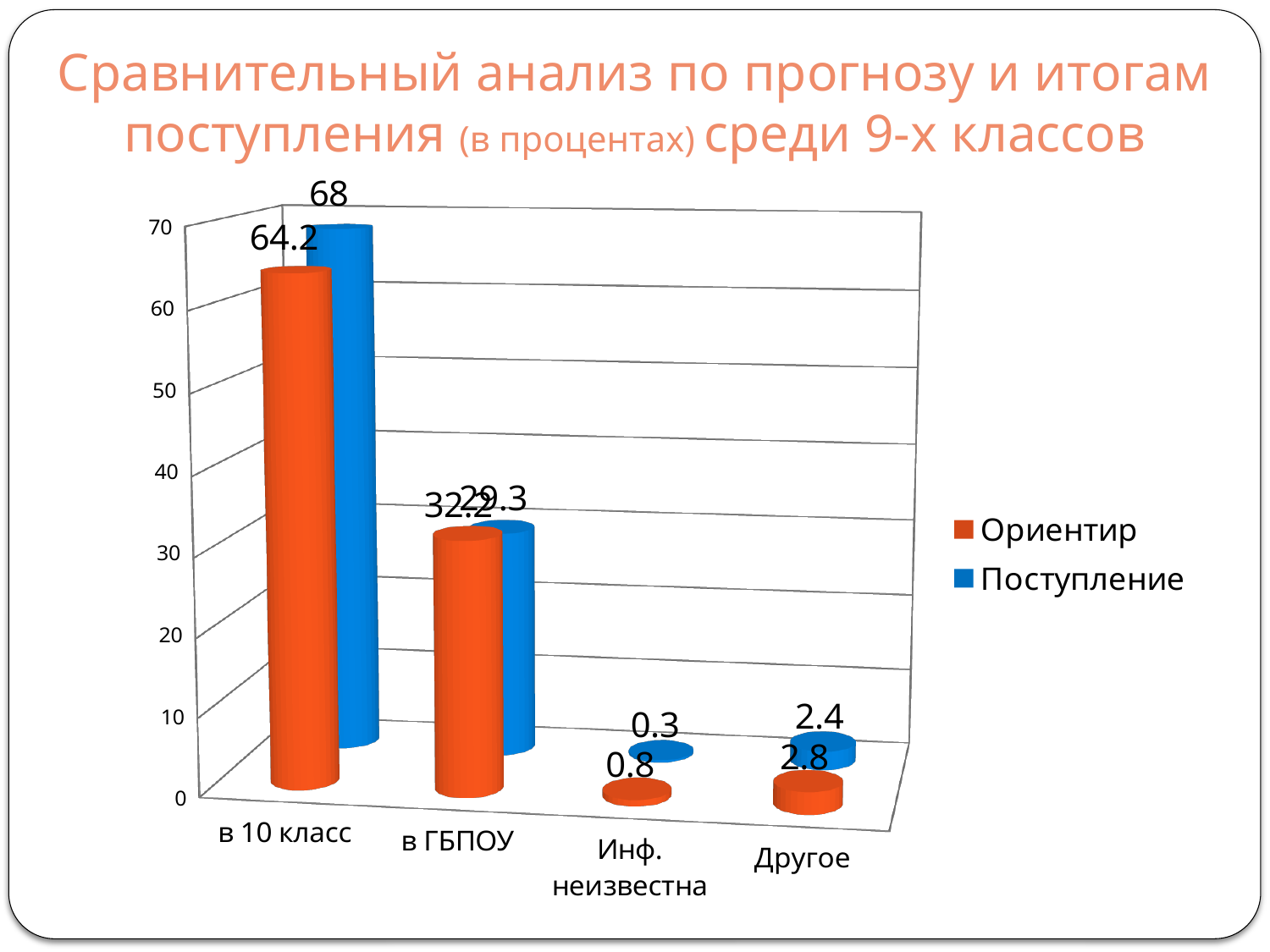
Which category has the highest Поступление value? в 10 класс How many categories are shown on the x axis? 4 What is the Ориентир value for в 10 класс? 64.2 What is the Ориентир value for Другое? 2.8 What kind of chart is shown on the slide? bar chart What is the difference between the Поступление and Ориентир values for в 10 класс? 3.8 What is the Поступление value for в 10 класс? 68 How many series does the legend list? 2 Which category has the lowest Ориентир value? Инф. неизвестна What is the Поступление value for Инф. неизвестна? 0.3 Is the Ориентир value for в ГБПОУ greater or less than 40? less For Другое, which is larger: Ориентир or Поступление? Ориентир